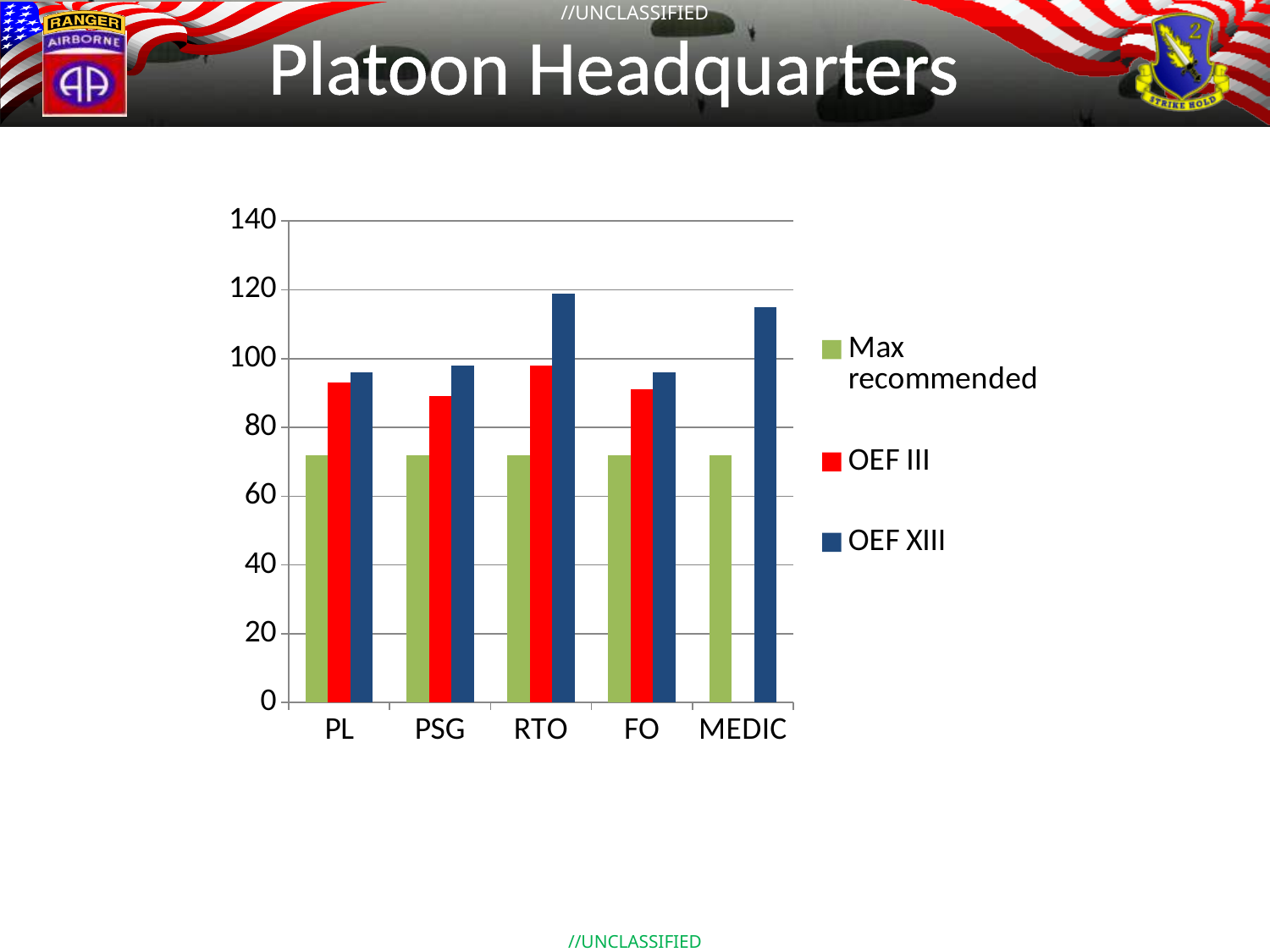
Which category has no OEF III bar in the chart? MEDIC Is the OEF III value for PL greater or less than 100? less Is the OEF XIII value for MEDIC greater or less than 100? greater Is the OEF III value for PSG greater or less than 80? greater How many series does the chart's legend list? 3 Which category has the highest OEF III value? RTO What kind of chart is shown on the slide? bar chart How many categories are shown on the x axis of the chart? 5 For RTO, which is larger: the OEF III value or the OEF XIII value? OEF XIII Which series is shown in red in the chart? OEF III